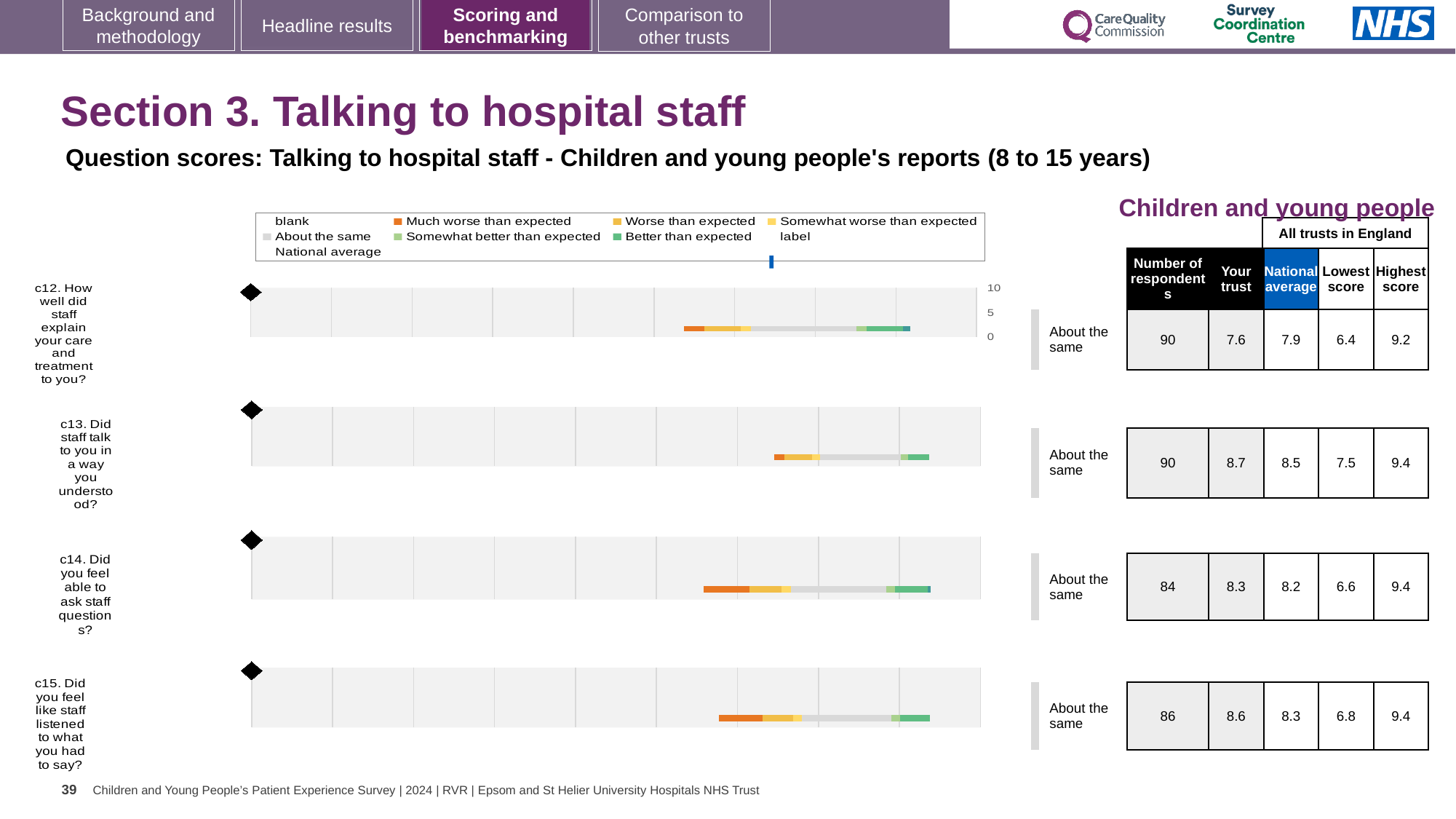
What kind of chart is used to show the benchmarking results for each question on this slide? bar chart What benchmark category is shown for question c12 (How well did staff explain your care and treatment to you?)? About the same Which question has the highest 'Your trust' score? c13 In the chart legend, which colour represents 'Much worse than expected'? orange What is the national average score for question c12 (How well did staff explain your care and treatment to you?)? 7.9 For question c14, which is larger: the 'Your trust' score or the national average? Your trust Which question has the lowest 'Your trust' score? c12 For question c13, what is the difference between the 'Your trust' score and the national average? 0.2 What is the 'Your trust' score for question c13 (Did staff talk to you in a way you understood?)? 8.7 What is the lowest score among all trusts in England for question c15 (Did you feel like staff listened to what you had to say?)? 6.8 How many survey questions (c12 to c15) are charted on this slide? 4 How many respondents answered question c14 (Did you feel able to ask staff questions?)? 84